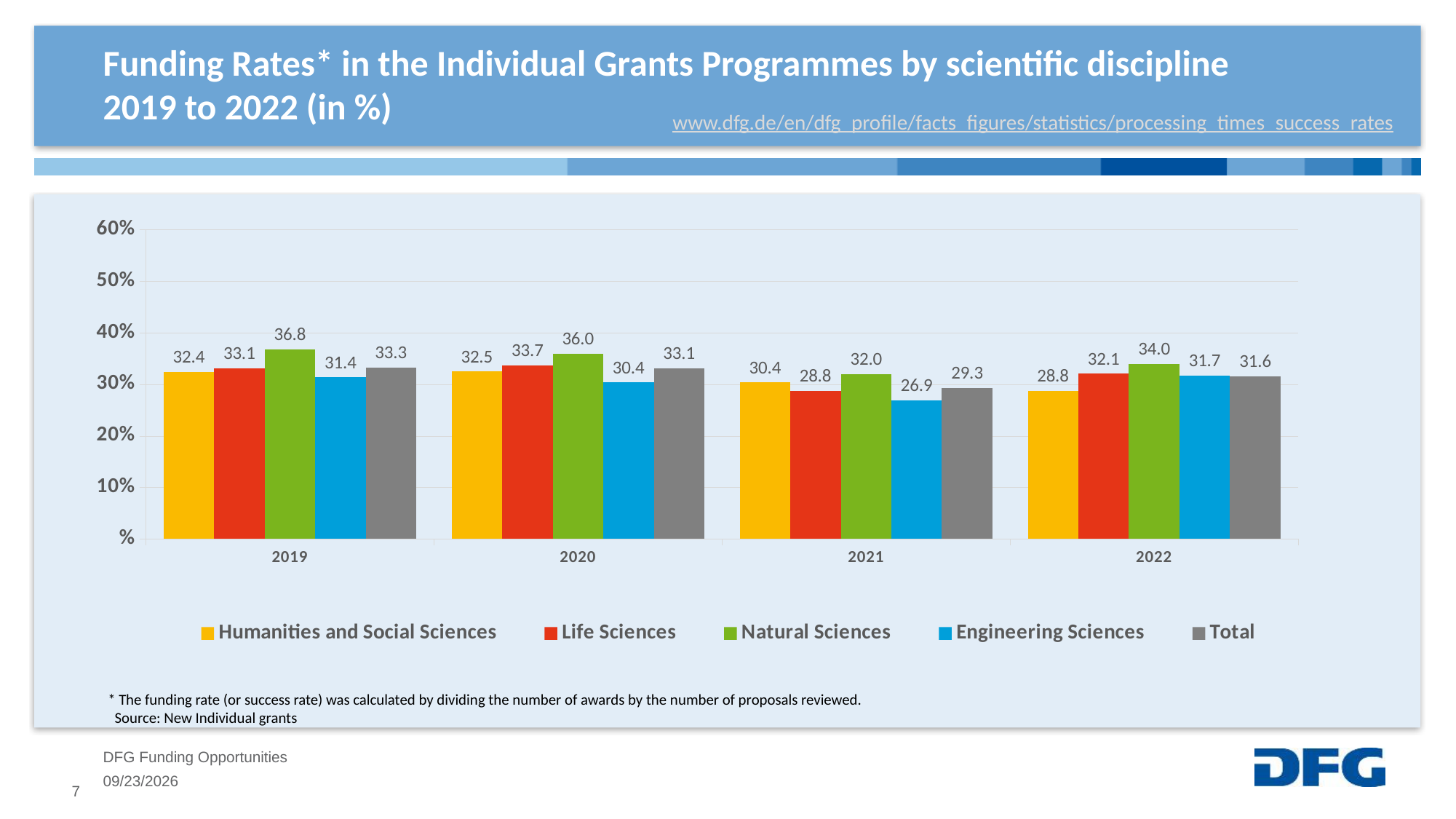
Which discipline has the highest funding rate in 2020? Natural Sciences What is the Total funding rate in 2022? 31.6 What is the funding rate for Natural Sciences in 2019? 36.8 Does the Total funding rate rise or fall from 2019 to 2021? Fall How many series does the legend list? 5 Which is larger in 2021: the funding rate for Humanities and Social Sciences or for Life Sciences? Humanities and Social Sciences Is the Total funding rate for 2021 greater or less than 30%? less What is the difference between the Natural Sciences and Engineering Sciences funding rates in 2019? 5.4 How many years are shown on the x axis? 4 What is the funding rate for Engineering Sciences in 2021? 26.9 What kind of chart is shown on the slide? Bar chart Which discipline has the lowest funding rate in 2022? Humanities and Social Sciences